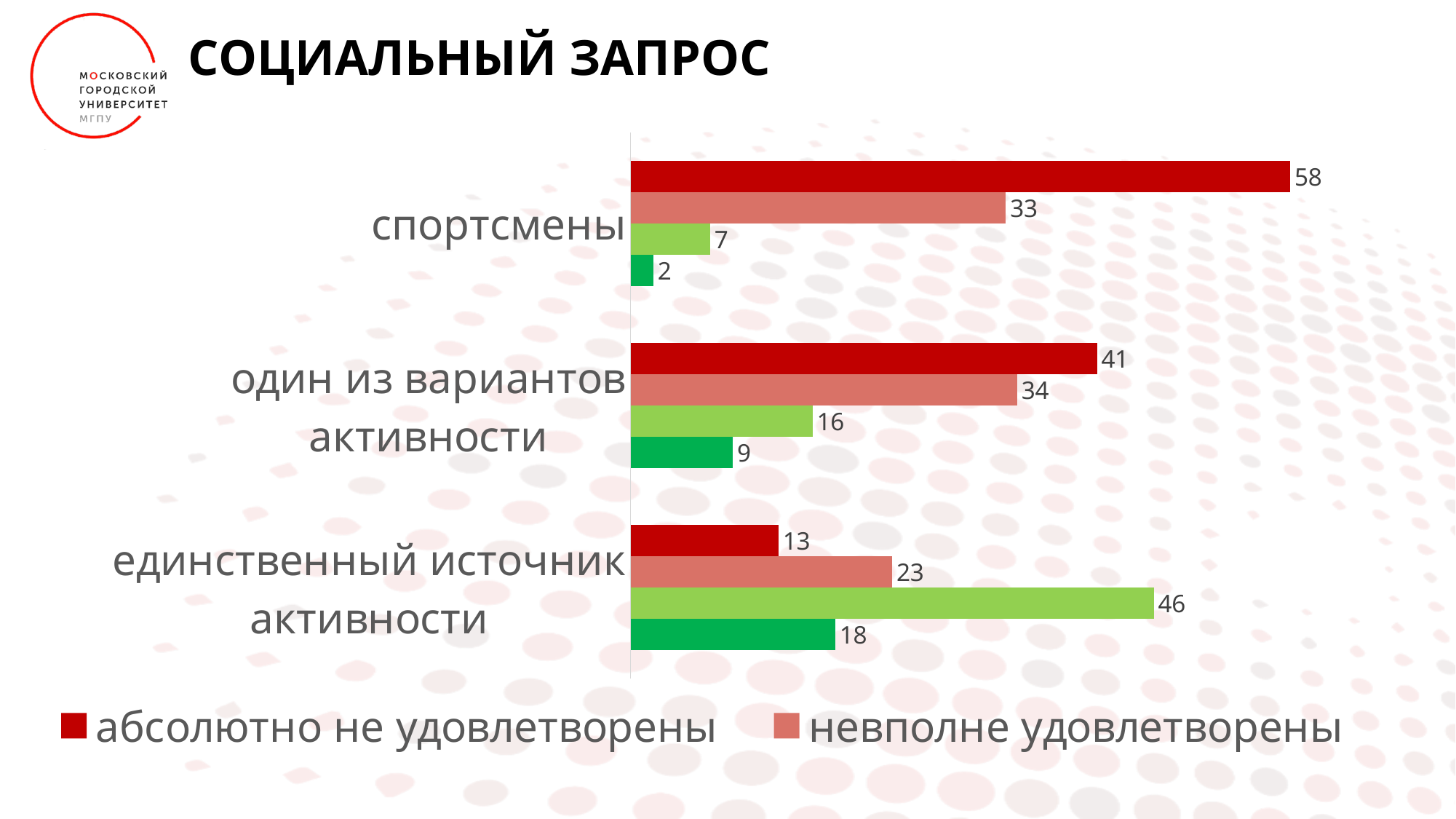
In the 'единственный источник активности' category, which is larger: 'абсолютно не удовлетворены' or 'невполне удовлетворены'? невполне удовлетворены In the 'спортсмены' category, what is the difference between 'абсолютно не удовлетворены' and 'невполне удовлетворены'? 25 How many categories are shown on the chart? 3 Which category has the lowest value for 'невполне удовлетворены'? единственный источник активности What is the value for 'невполне удовлетворены' in the 'спортсмены' category? 33 Which category has the highest value for 'абсолютно не удовлетворены'? спортсмены How many series does the legend list? 2 What is the value for 'абсолютно не удовлетворены' in the 'спортсмены' category? 58 What is the value for 'абсолютно не удовлетворены' in the 'единственный источник активности' category? 13 What type of chart is shown on the slide? bar chart What is the value for 'невполне удовлетворены' in the 'один из вариантов активности' category? 34 What is the difference in 'абсолютно не удовлетворены' between 'один из вариантов активности' and 'единственный источник активности'? 28